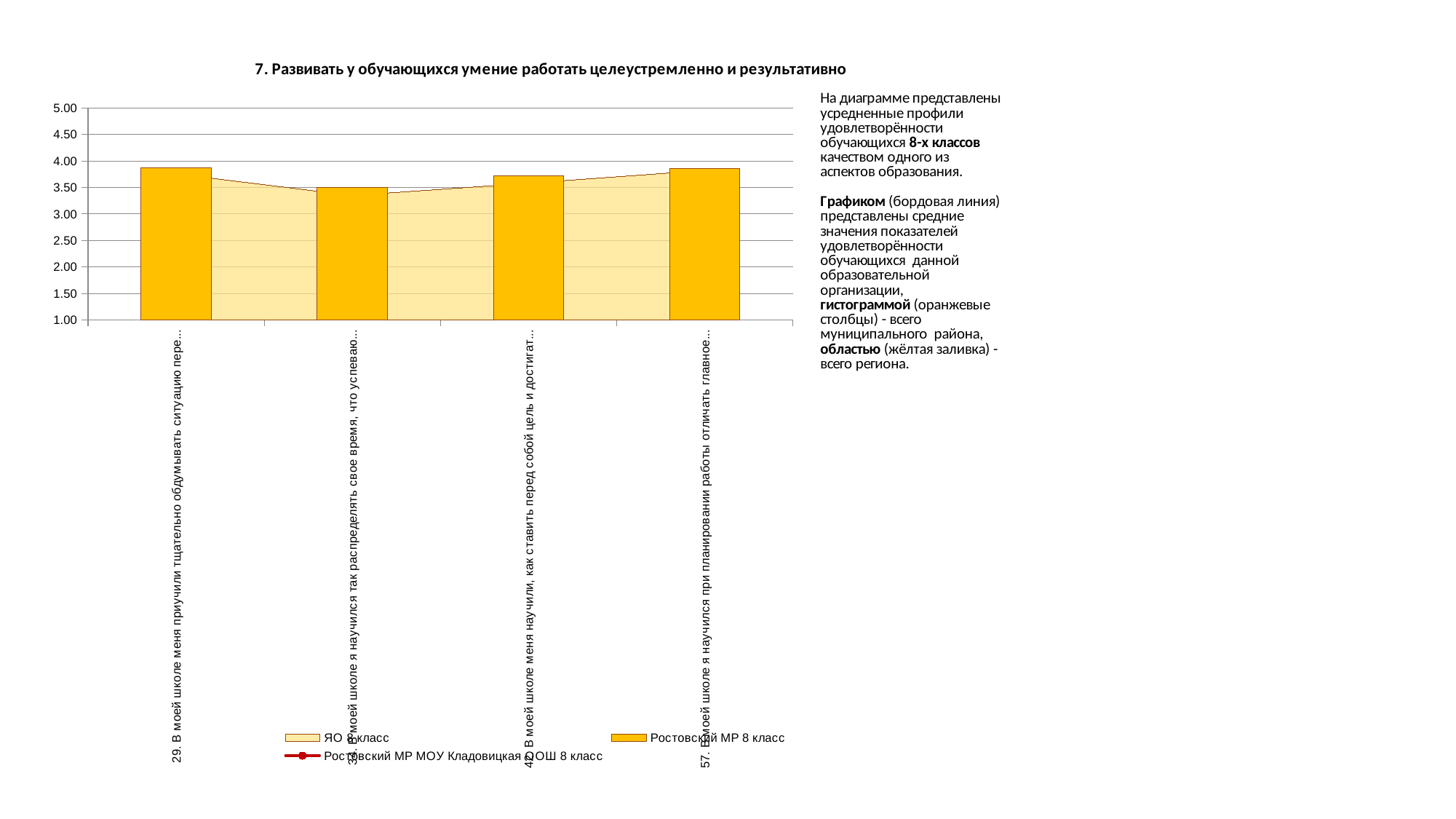
Is the orange bar (Ростовский МР 8 класс) for question 29 greater or less than 3.50? greater What is the title of the chart? 7. Развивать у обучающихся умение работать целеустремленно и результативно Is the orange bar (Ростовский МР 8 класс) for question 42 greater or less than 4.00? less Which series in the legend is shown as orange bars? Ростовский МР 8 класс Is the orange bar (Ростовский МР 8 класс) for question 57 greater or less than 3.50? greater How many categories (questions) are shown along the x axis of the chart? 4 Which category has the lowest orange bar (Ростовский МР 8 класс)? 34 How many series does the chart legend list? 3 What is the highest value shown on the vertical axis of the chart? 5.00